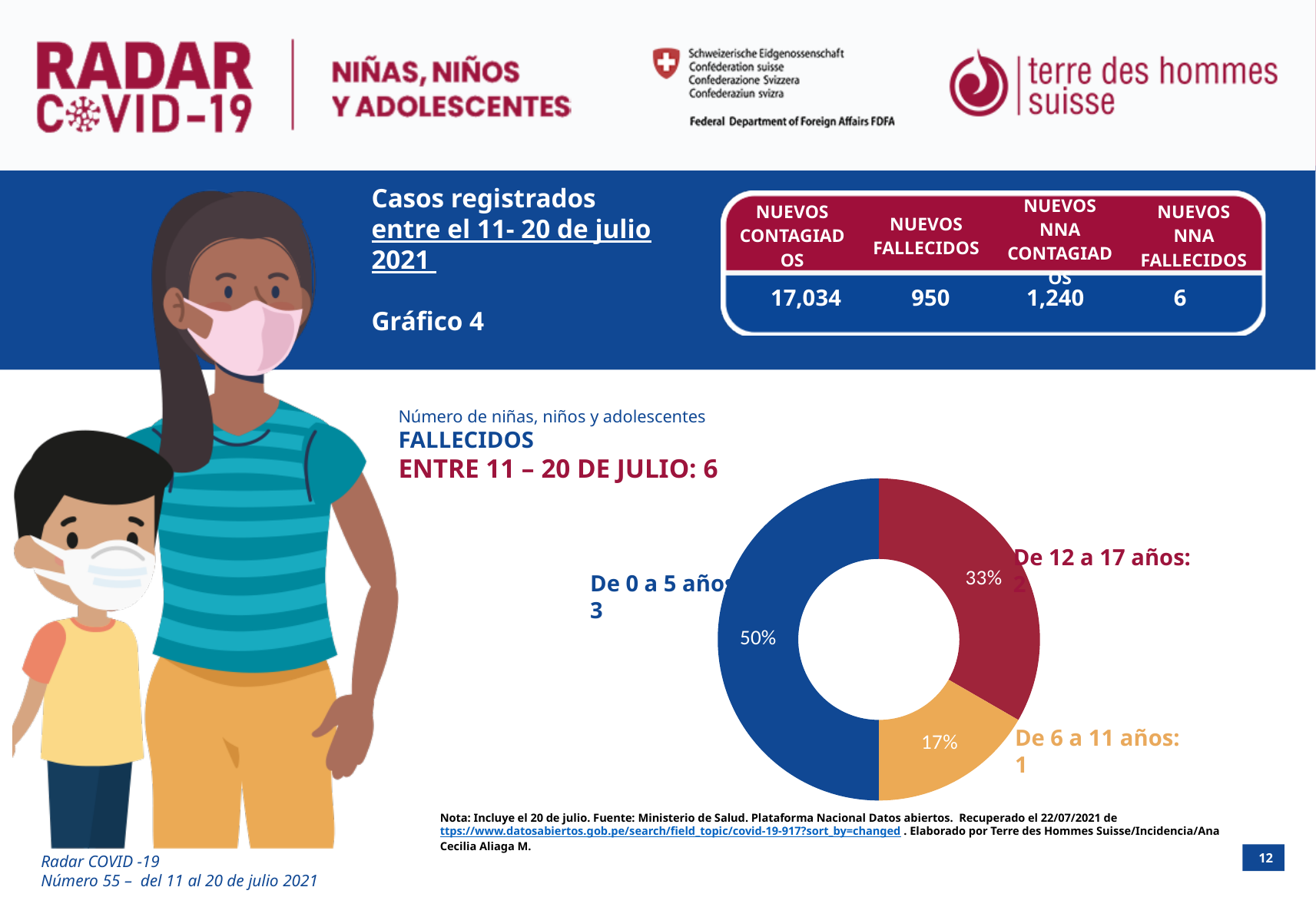
How many deaths are shown for the 'De 0 a 5 años' category? 3 What kind of chart is shown on the slide? Pie chart (donut) What is the difference in percentage points between the 'De 0 a 5 años' slice and the 'De 6 a 11 años' slice? 33 percentage points What percentage of the donut chart corresponds to 'De 6 a 11 años'? 17% Which is larger in the donut chart: the share for 'De 12 a 17 años' or 'De 6 a 11 años'? De 12 a 17 años Which age category has the largest share of the donut chart? De 0 a 5 años What is the total number of deaths (fallecidos) of children and adolescents shown in the chart title for 11–20 July? 6 What percentage of the donut chart corresponds to 'De 12 a 17 años'? 33% How many deaths are shown for the 'De 6 a 11 años' category? 1 How many age categories does the donut chart show? 3 Which age category has the smallest share of the donut chart? De 6 a 11 años What percentage of the donut chart corresponds to 'De 0 a 5 años'? 50%